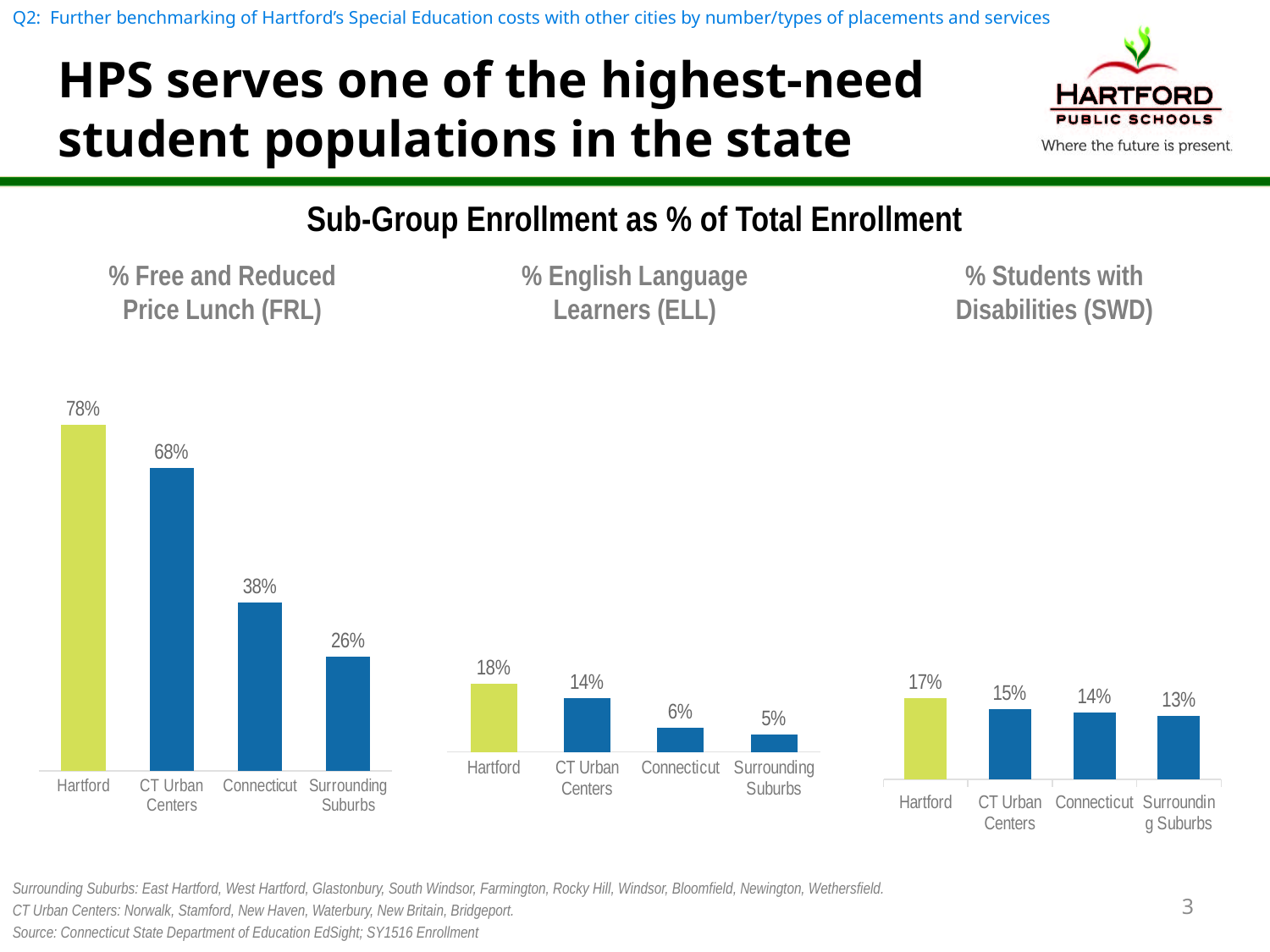
How many categories are shown in the '% Students with Disabilities (SWD)' chart? 4 What type of chart is the '% Free and Reduced Price Lunch (FRL)' chart? Bar chart In the '% English Language Learners (ELL)' chart, do the values rise or fall from Hartford to Surrounding Suburbs? Fall In the '% Free and Reduced Price Lunch (FRL)' chart, what is the difference between Hartford and CT Urban Centers? 10% In the '% English Language Learners (ELL)' chart, what is the value for Connecticut? 6% In the '% English Language Learners (ELL)' chart, which category has the highest value? Hartford In the '% Students with Disabilities (SWD)' chart, what is the value for Surrounding Suburbs? 13% In the '% Free and Reduced Price Lunch (FRL)' chart, which category has the lowest value? Surrounding Suburbs What is the overall title above the three charts? Sub-Group Enrollment as % of Total Enrollment In the '% Students with Disabilities (SWD)' chart, what is the difference between Hartford and Connecticut? 3% In the '% Free and Reduced Price Lunch (FRL)' chart, what is the value for Hartford? 78% In the '% English Language Learners (ELL)' chart, which is larger: CT Urban Centers or Surrounding Suburbs? CT Urban Centers